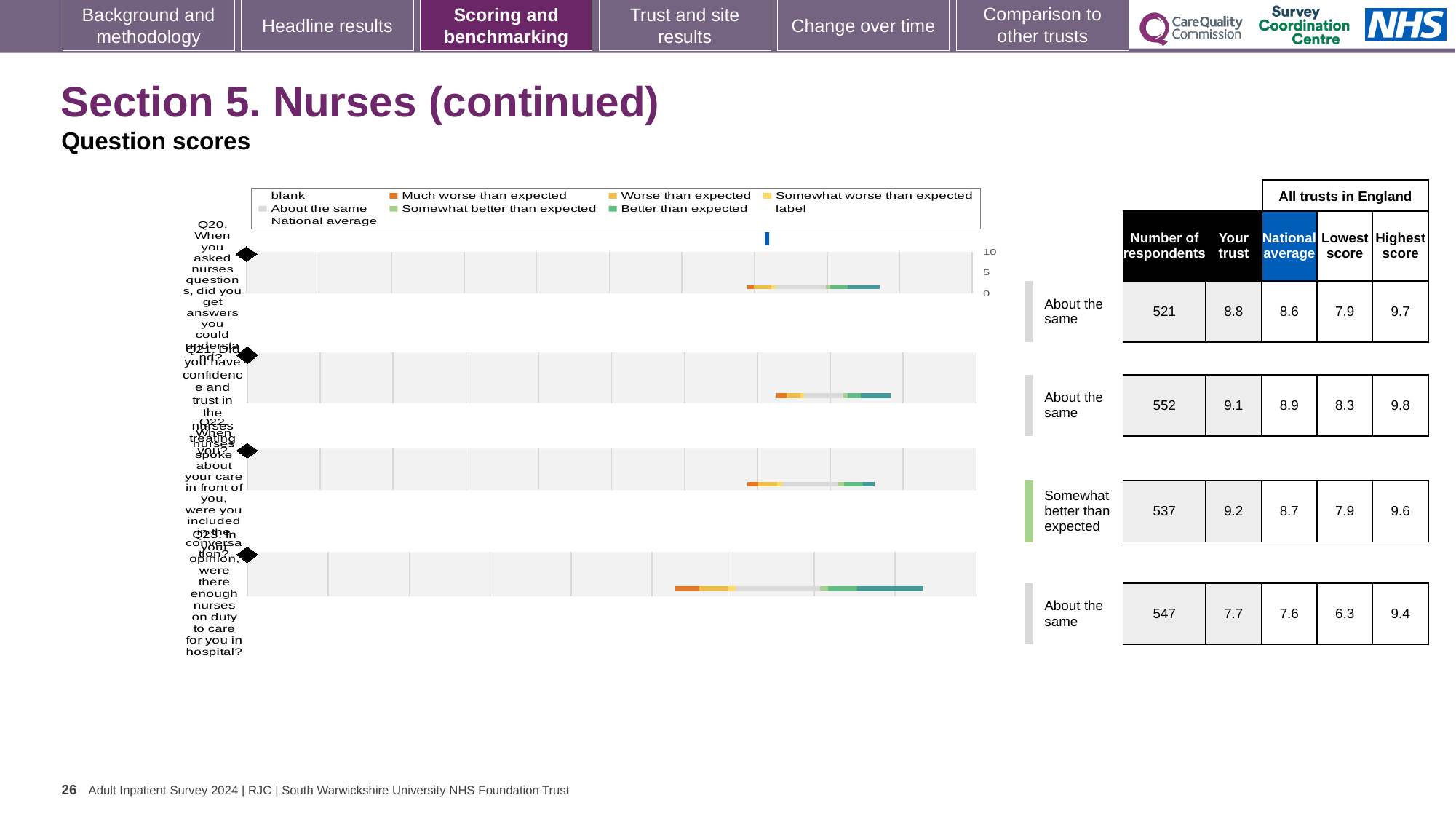
Which benchmark category is Q22 assigned to? Somewhat better than expected In the table, what is the national average for Q23 (enough nurses on duty)? 7.6 In the table, what is the highest score across all trusts in England for Q22? 9.6 In the table, what is the 'Your trust' score for Q21 (confidence and trust in nurses)? 9.1 What is the difference between the 'Your trust' score and the national average for Q22? 0.5 In the chart legend, which colour represents 'Much worse than expected'? orange Which question has the lowest 'Your trust' score in the table? Q23 In the table, what is the number of respondents for Q20? 521 What type of chart is used to show the question scores on this slide? bar chart Which question has the highest 'Your trust' score in the table? Q22 How many questions (rows) are plotted in the chart? 4 What is the maximum value shown on the chart's score axis? 10